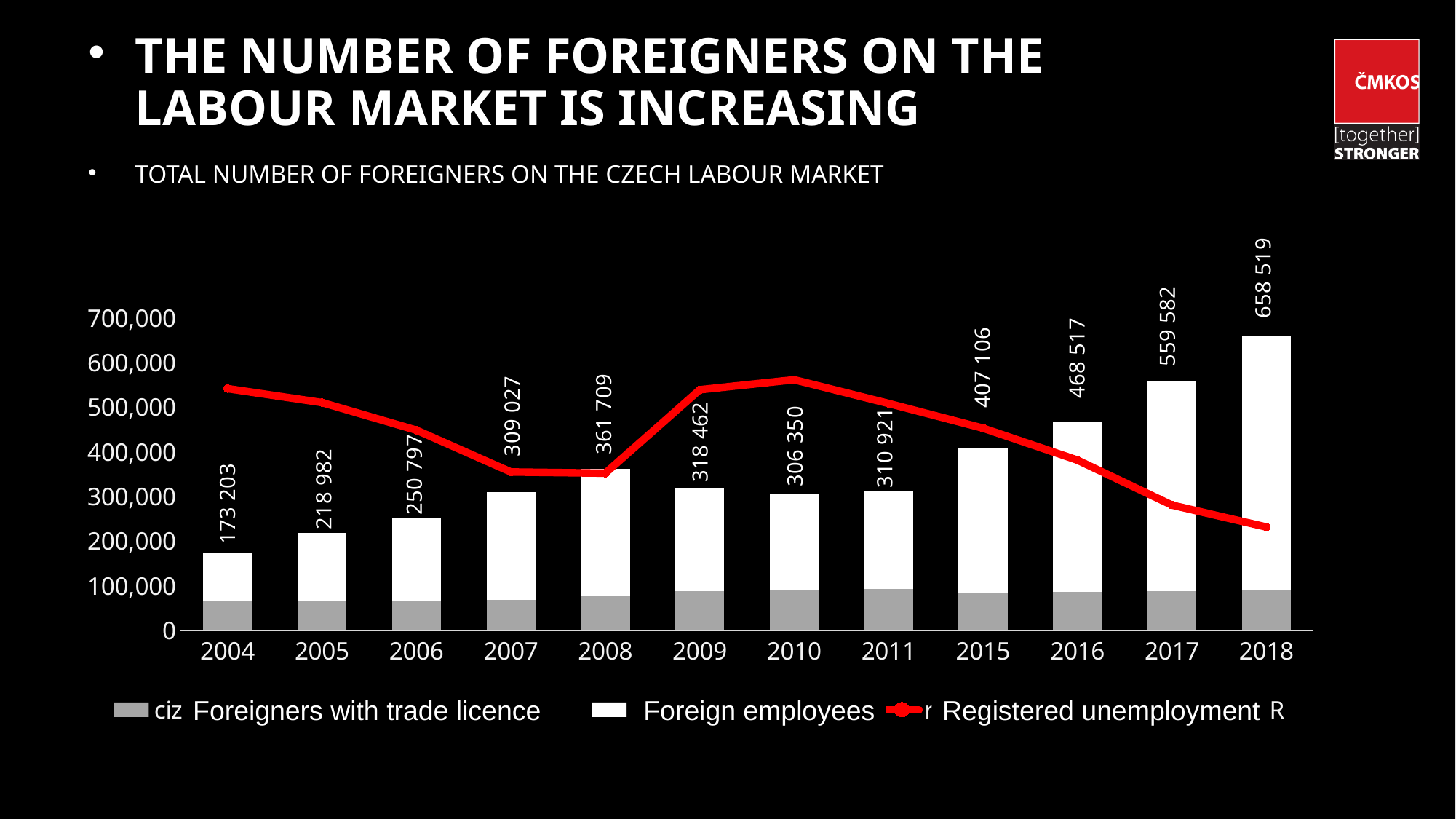
Which year has the highest total number of foreigners on the labour market? 2018 What is the total number of foreigners on the Czech labour market shown for 2004? 173 203 Which year has the lowest total number of foreigners on the labour market? 2004 How many series does the chart legend list? 3 What is the total number of foreigners on the Czech labour market shown for 2018? 658 519 What is the total number of foreigners on the Czech labour market shown for 2015? 407 106 Does the registered unemployment line rise or fall from 2010 to 2018? fall Which year has a larger total number of foreigners, 2008 or 2009? 2008 Is the registered unemployment value for 2018 greater or less than 300,000? less What is the difference between the totals for 2005 and 2004? 45 779 How many years are shown on the x axis of the chart? 12 By how much did the total number of foreigners increase from 2017 to 2018? 98 937